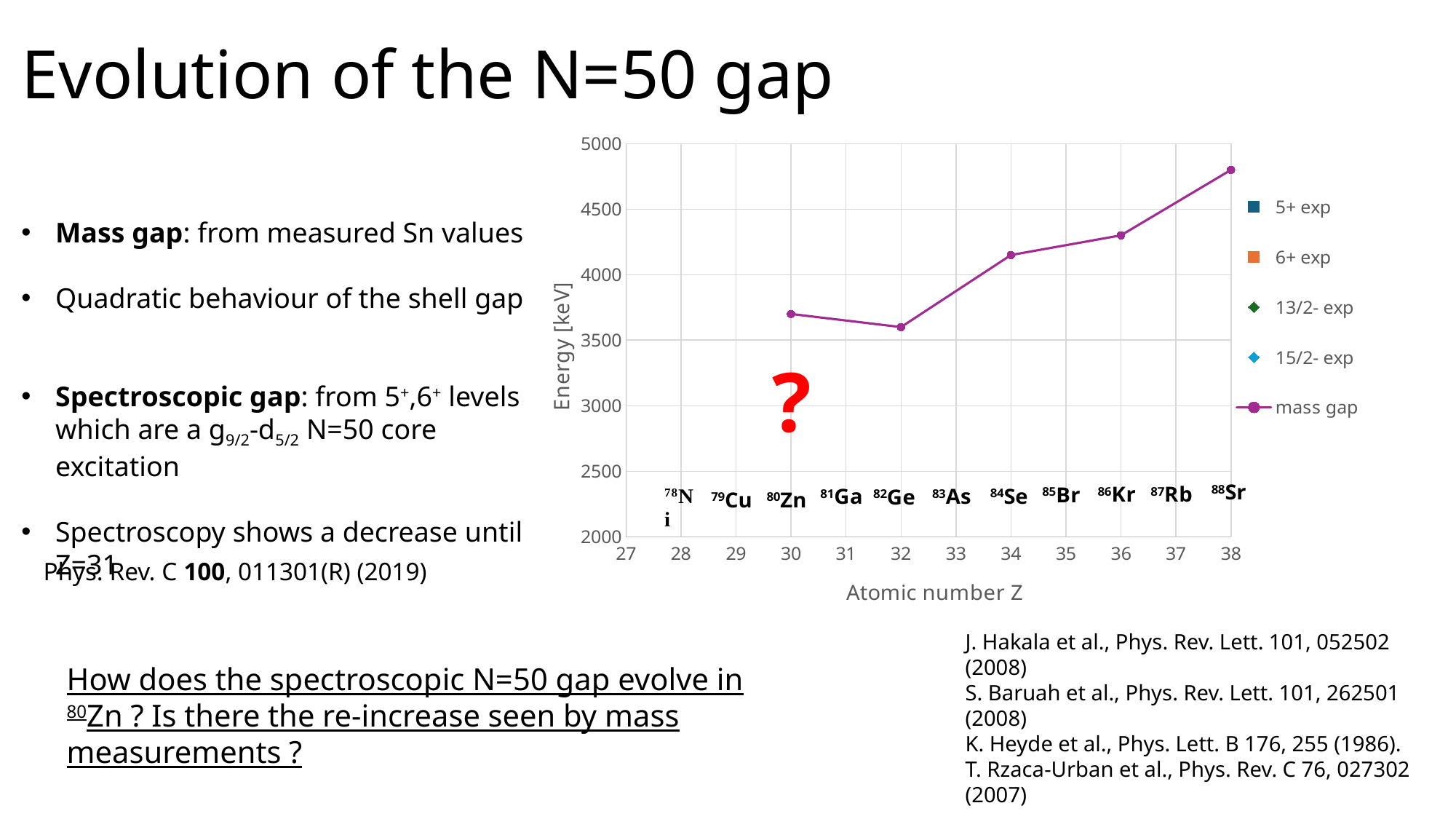
Does the mass gap rise or fall from Z=32 to Z=38? rise How many series does the chart legend list? 5 Which has the larger mass gap value, Z=30 or Z=32? Z=30 Is the mass gap value at Z=30 greater or less than 3500? greater At which atomic number Z is the mass gap lowest? 32 What is the label of the y axis? Energy [keV] Is the mass gap value at Z=38 greater or less than 4500? greater Is the mass gap value at Z=32 greater or less than 4000? less What kind of chart is shown on the slide? line chart At which atomic number Z is the mass gap highest? 38 How many data points are plotted on the mass gap line? 5